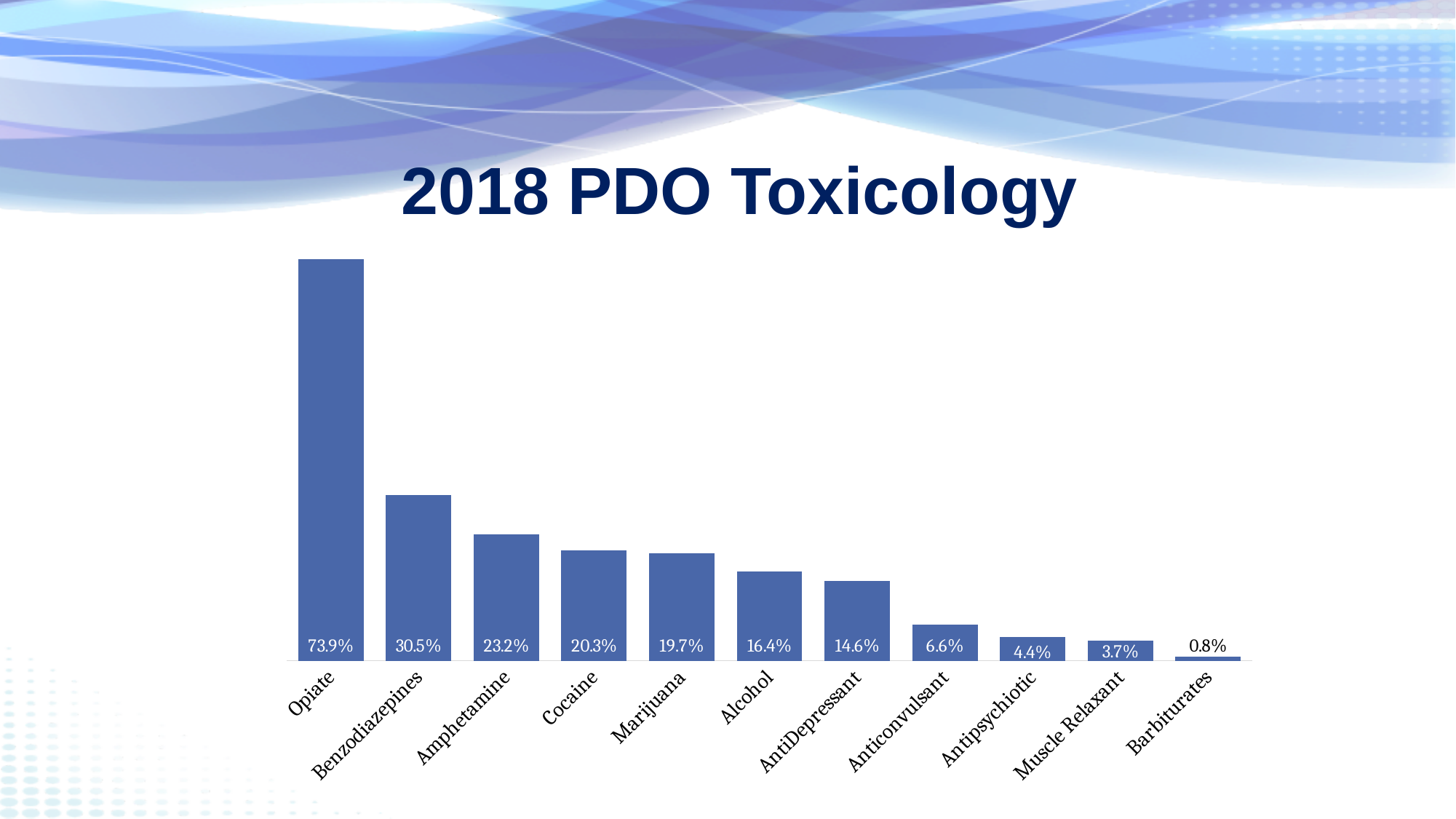
Which is larger, the value for Amphetamine or the value for Cocaine? Amphetamine Which is larger, the value for Antipsychiotic or the value for Muscle Relaxant? Antipsychiotic Do the values rise or fall from left to right along the x axis? Fall What is the value for Marijuana? 19.7% What is the value for Opiate? 73.9% What kind of chart is shown on the slide? Bar chart How many categories are shown in the chart? 11 What is the difference between the values for Opiate and Benzodiazepines? 43.4% Which category has the lowest value? Barbiturates What is the value for Anticonvulsant? 6.6% Which category has the highest value? Opiate What is the difference between the values for Alcohol and AntiDepressant? 1.8%